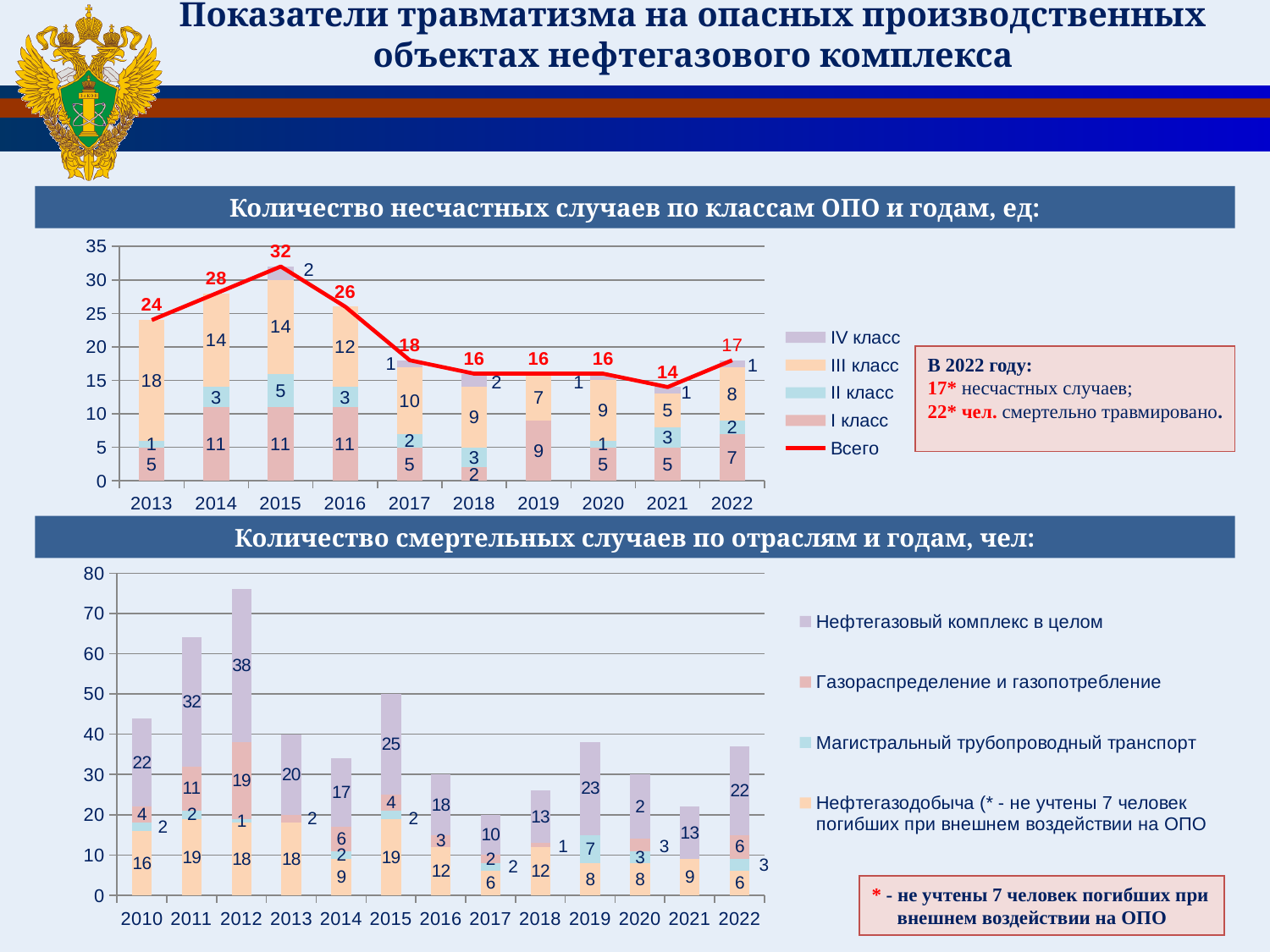
In the top chart 'Количество несчастных случаев по классам ОПО и годам', which year has the lowest 'Всего' value? 2021 In the bottom chart 'Количество смертельных случаев по отраслям и годам', how many series does the legend list? 4 In the top chart 'Количество несчастных случаев по классам ОПО и годам', what is the difference between the 'Всего' values for 2014 and 2013? 4 In the bottom chart 'Количество смертельных случаев по отраслям и годам', what is the total of the stacked bar for 2010? 44 In the bottom chart 'Количество смертельных случаев по отраслям и годам', what is the value for 'Нефтегазодобыча' in 2011? 19 In the top chart 'Количество несчастных случаев по классам ОПО и годам', what is the value for 'III класс' in 2013? 18 In the bottom chart 'Количество смертельных случаев по отраслям и годам', what is the value for 'Нефтегазовый комплекс в целом' in 2012? 38 In the top chart 'Количество несчастных случаев по классам ОПО и годам', which year has the highest 'Всего' value? 2015 In the top chart 'Количество несчастных случаев по классам ОПО и годам', what is the value of 'Всего' for 2015? 32 In the top chart 'Количество несчастных случаев по классам ОПО и годам', how many years are shown on the x axis? 10 In the top chart 'Количество несчастных случаев по классам ОПО и годам', how many series does the legend list? 5 In the top chart 'Количество несчастных случаев по классам ОПО и годам', does the 'Всего' line rise or fall from 2015 to 2018? fall